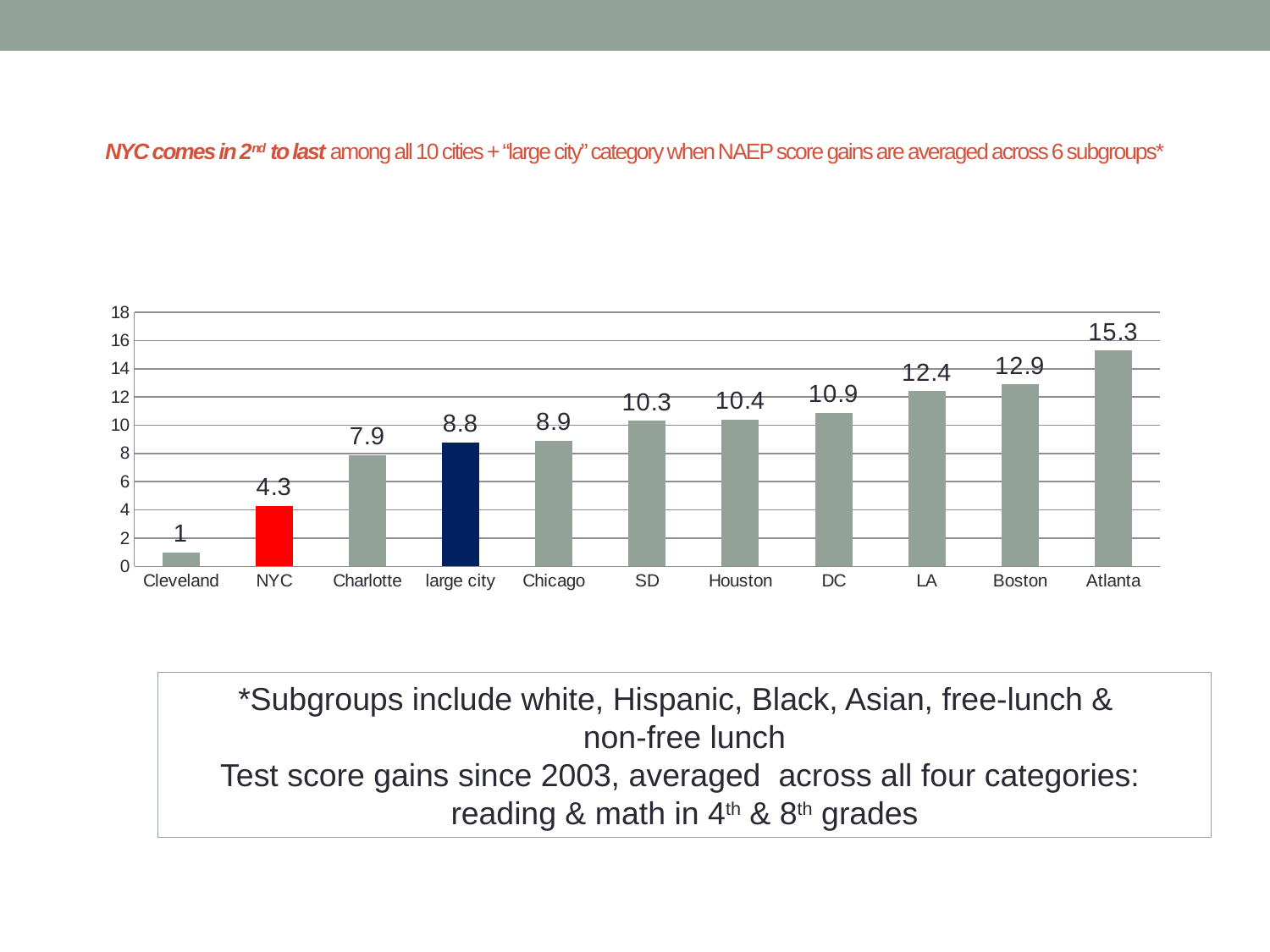
What is the value for Houston? 10.4 Which bar is coloured red? NYC What is the value for NYC? 4.3 What kind of chart is shown on the slide? Bar chart What is the difference between the values for Atlanta and Cleveland? 14.3 Which category has the lowest value? Cleveland What is the difference between the values for Boston and LA? 0.5 Do the values rise or fall from left to right along the x axis? Rise What is the value for the large city category? 8.8 Which category has the highest value? Atlanta How many categories are shown on the x axis? 11 Which is larger, the value for Charlotte or the value for Chicago? Chicago